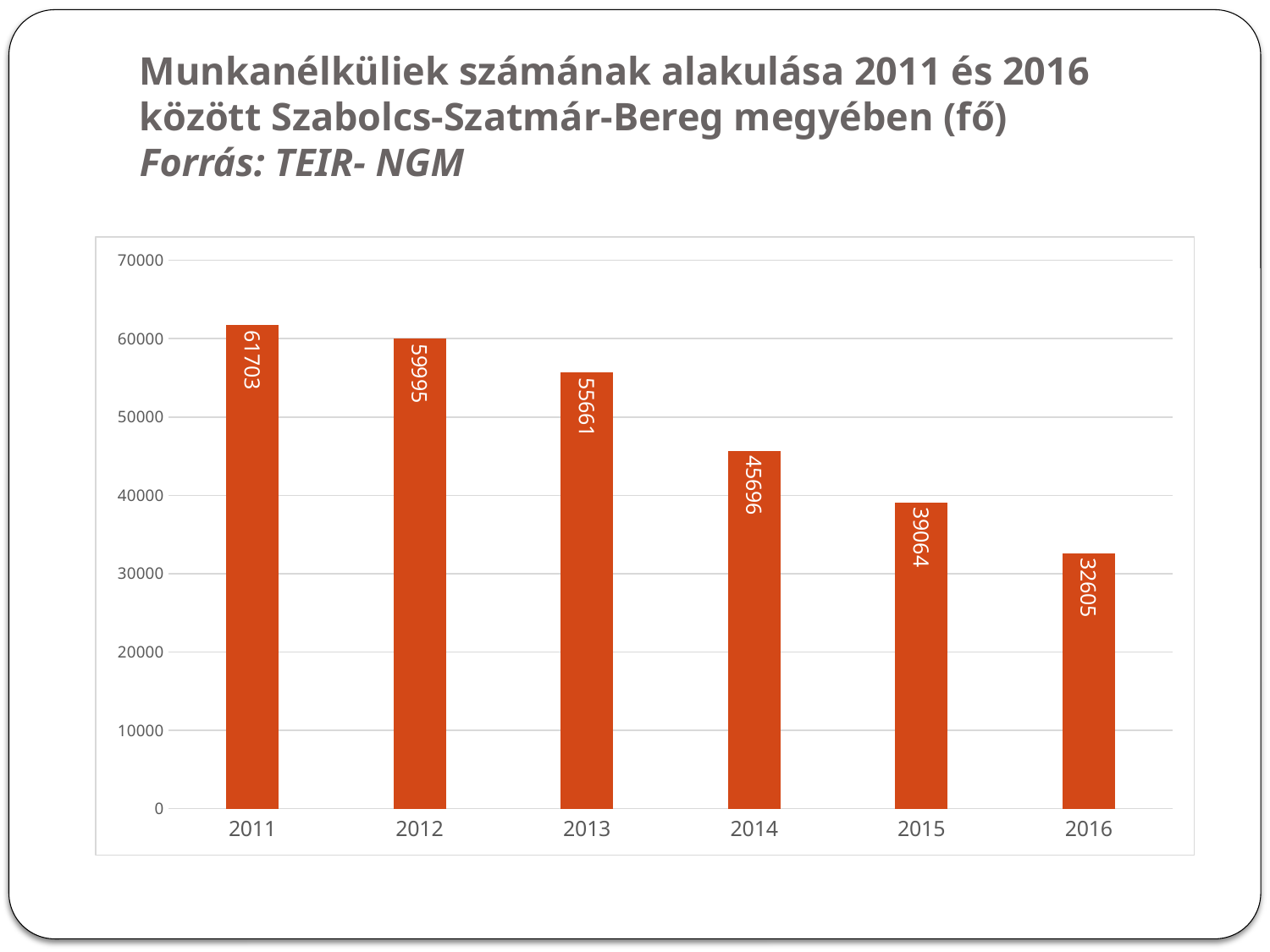
Which is larger, the value for 2012 or the value for 2015? 2012 Which year has the highest value? 2011 What is the difference between the values for 2013 and 2014? 9965 What is the value for 2016? 32605 How many years are shown on the x axis? 6 Do the values rise or fall from 2011 to 2016? fall What kind of chart is shown on the slide? bar chart What is the value for 2014? 45696 What is the value for 2011? 61703 Is the value for 2015 greater or less than 40000? less What is the difference between the values for 2011 and 2016? 29098 Which year has the lowest value? 2016